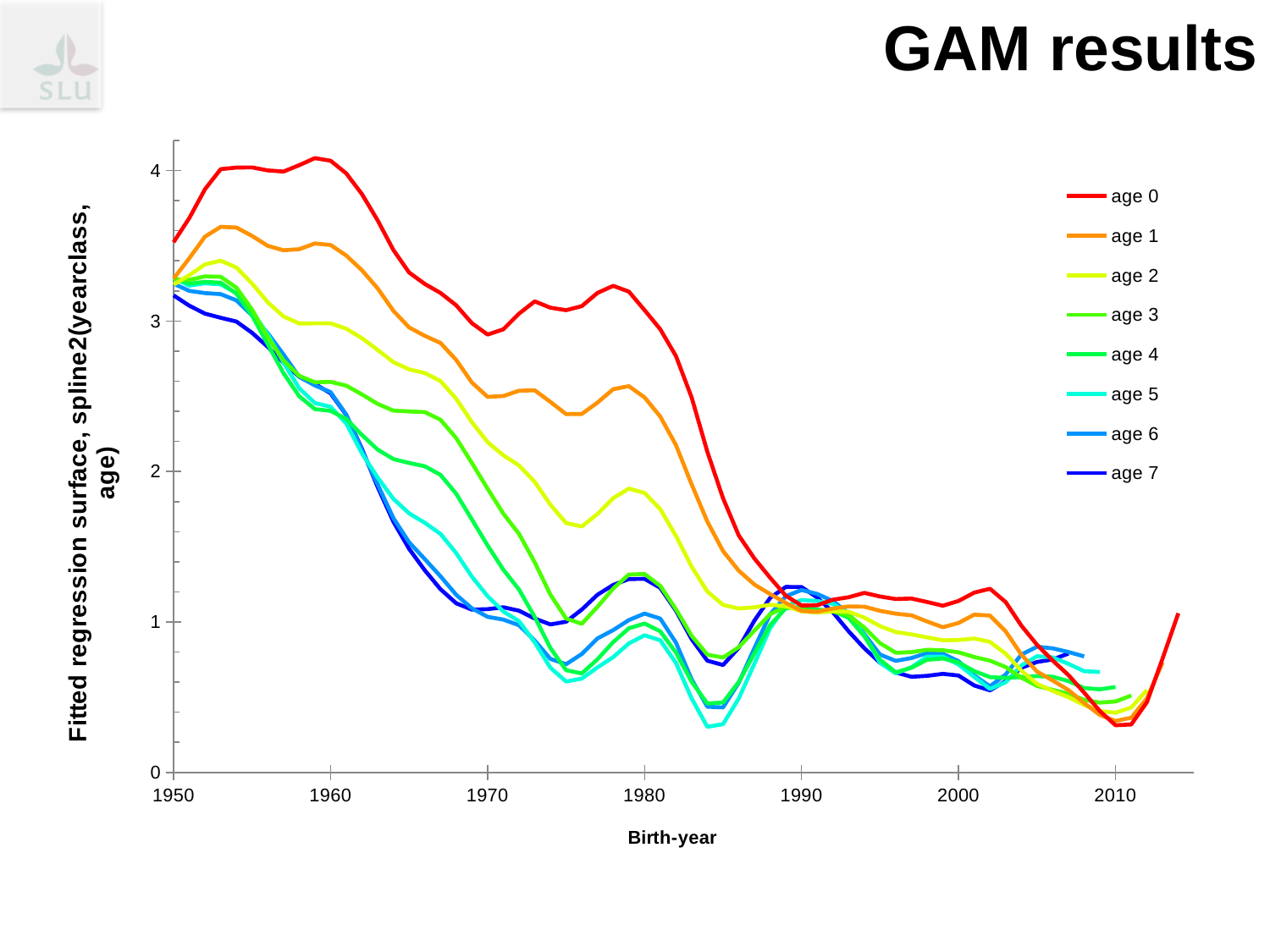
What is the title of the slide? GAM results Is the value for age 7 at birth-year 1970 greater or less than 2? less Does the age 0 line generally rise or fall from 1950 to 2010? fall Is the value for age 1 at birth-year 1990 greater or less than 2? less What kind of chart is shown on the slide? line chart At birth-year 1960, which is higher: age 0 or age 7? age 0 Is the value for age 0 at birth-year 1980 greater or less than 2? greater How many series does the legend list? 8 Which series has the lowest value at birth-year 1985? age 5 Which series has the highest value at birth-year 1970? age 0 What is the label of the x axis? Birth-year